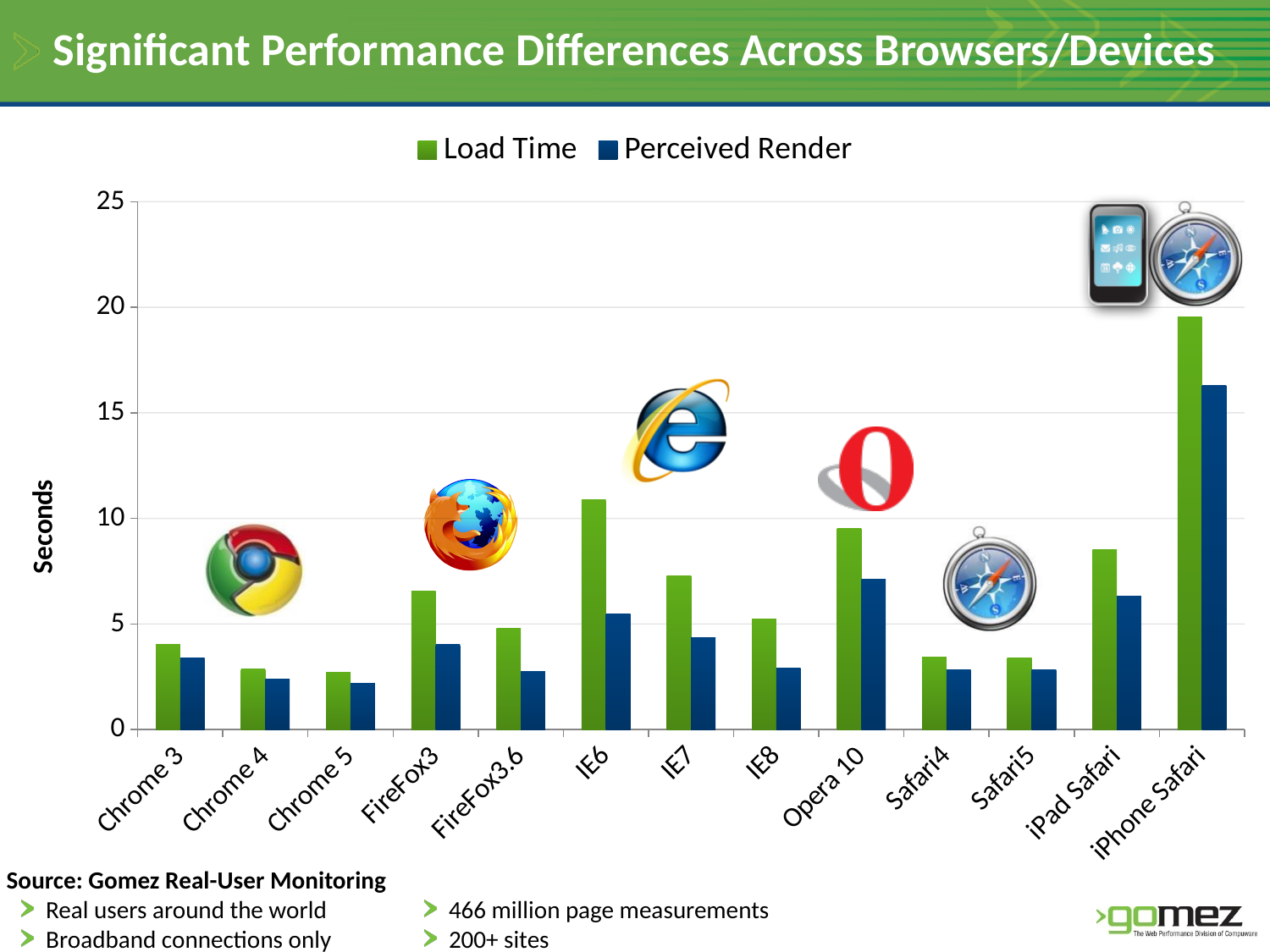
How many browser/device categories are shown on the x axis? 13 Which has the larger Load Time, IE6 or IE7? IE6 Which category has the highest Load Time? iPhone Safari What is the label on the y axis? Seconds Is the Perceived Render value for iPhone Safari greater or less than 15? greater How many series does the legend list? 2 Which category has the highest Perceived Render value? iPhone Safari Is the Load Time for Chrome 3 greater or less than 5? less Which has the larger Load Time, Chrome 3 or FireFox3? FireFox3 What kind of chart is shown on the slide? bar chart Is the Load Time for IE6 greater or less than 10? greater